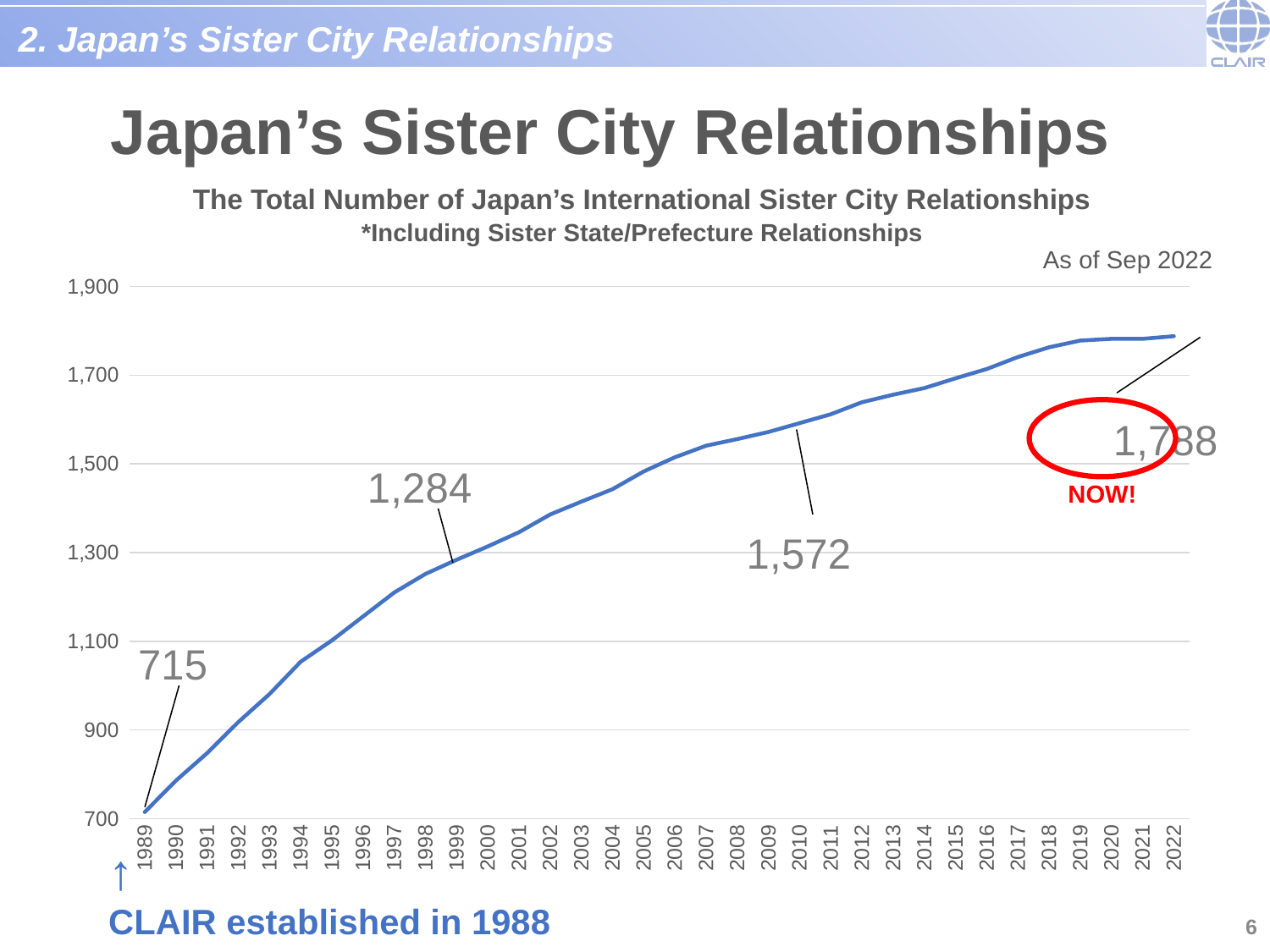
Is the value for 2014 greater or less than 1,700? less What was the total number of Japan's sister city relationships in 1999? 1,284 Which year has the highest number of sister city relationships? 2022 Do the values rise or fall from 1989 to 2022? rise What was the total number of Japan's sister city relationships in 2022? 1,788 By how much did the number of sister city relationships increase from 1989 to 2022? 1,073 How many years are shown on the x axis of the chart? 34 What kind of chart is shown on the slide? line chart What was the total number of Japan's sister city relationships in 1989? 715 Which year has the lowest number of sister city relationships? 1989